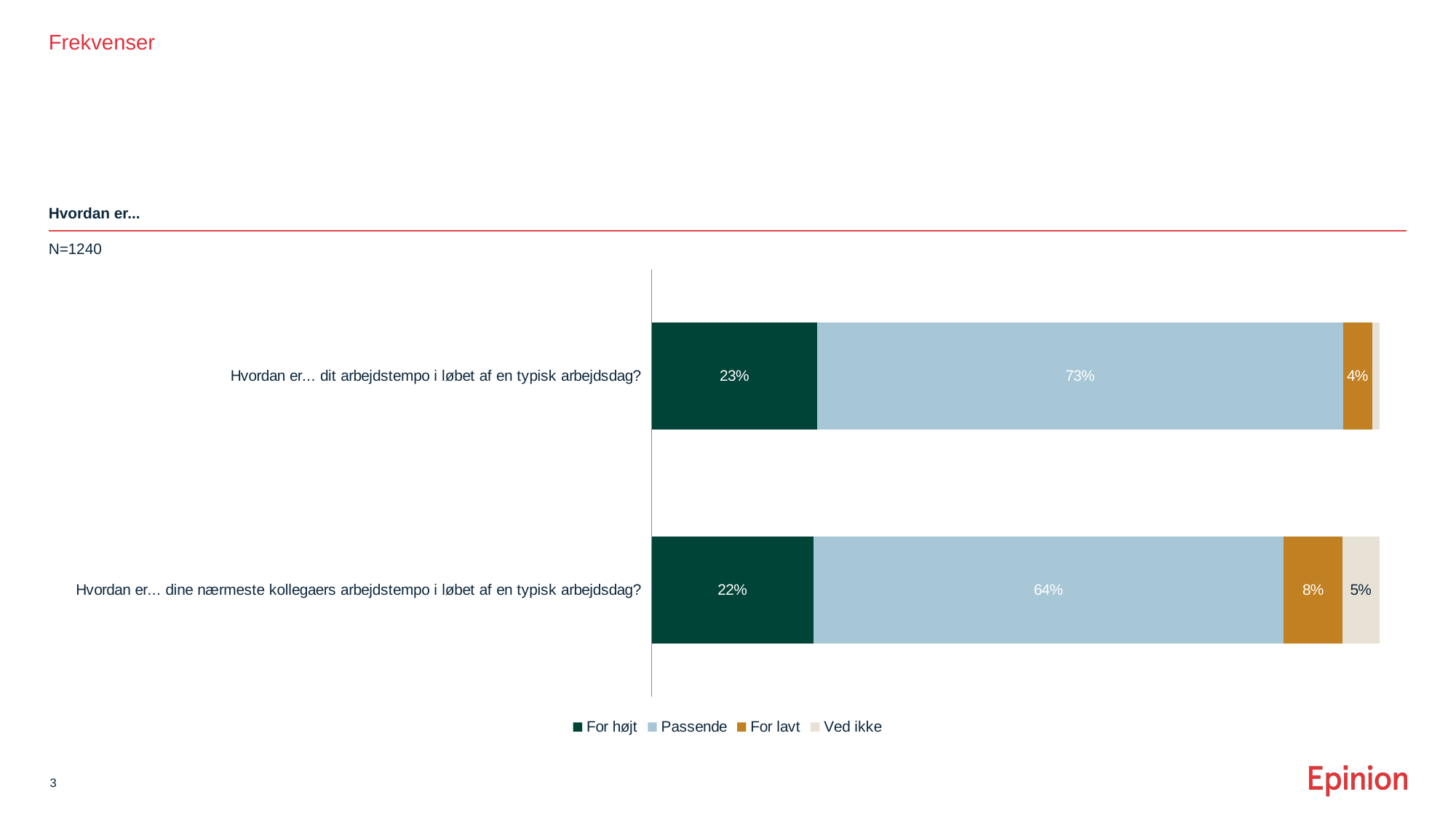
How many categories (questions) are plotted in the chart? 2 How many series does the legend list? 4 What is the 'Ved ikke' value for 'Hvordan er… dine nærmeste kollegaers arbejdstempo i løbet af en typisk arbejdsdag?'? 5% What type of chart is shown on the slide? Stacked bar chart What is the 'For lavt' value for 'Hvordan er… dit arbejdstempo i løbet af en typisk arbejdsdag?'? 4% Which series has the largest value in the bar for 'Hvordan er… dit arbejdstempo i løbet af en typisk arbejdsdag?'? Passende What is the 'Passende' value for 'Hvordan er… dit arbejdstempo i løbet af en typisk arbejdsdag?'? 73% Which question has the higher 'For lavt' value? Hvordan er… dine nærmeste kollegaers arbejdstempo i løbet af en typisk arbejdsdag? What is the last entry in the chart legend? Ved ikke What is the difference between the 'Passende' values for the two questions? 9 percentage points What is the sample size (N) shown above the chart? N=1240 What is the 'For højt' value for 'Hvordan er… dine nærmeste kollegaers arbejdstempo i løbet af en typisk arbejdsdag?'? 22%